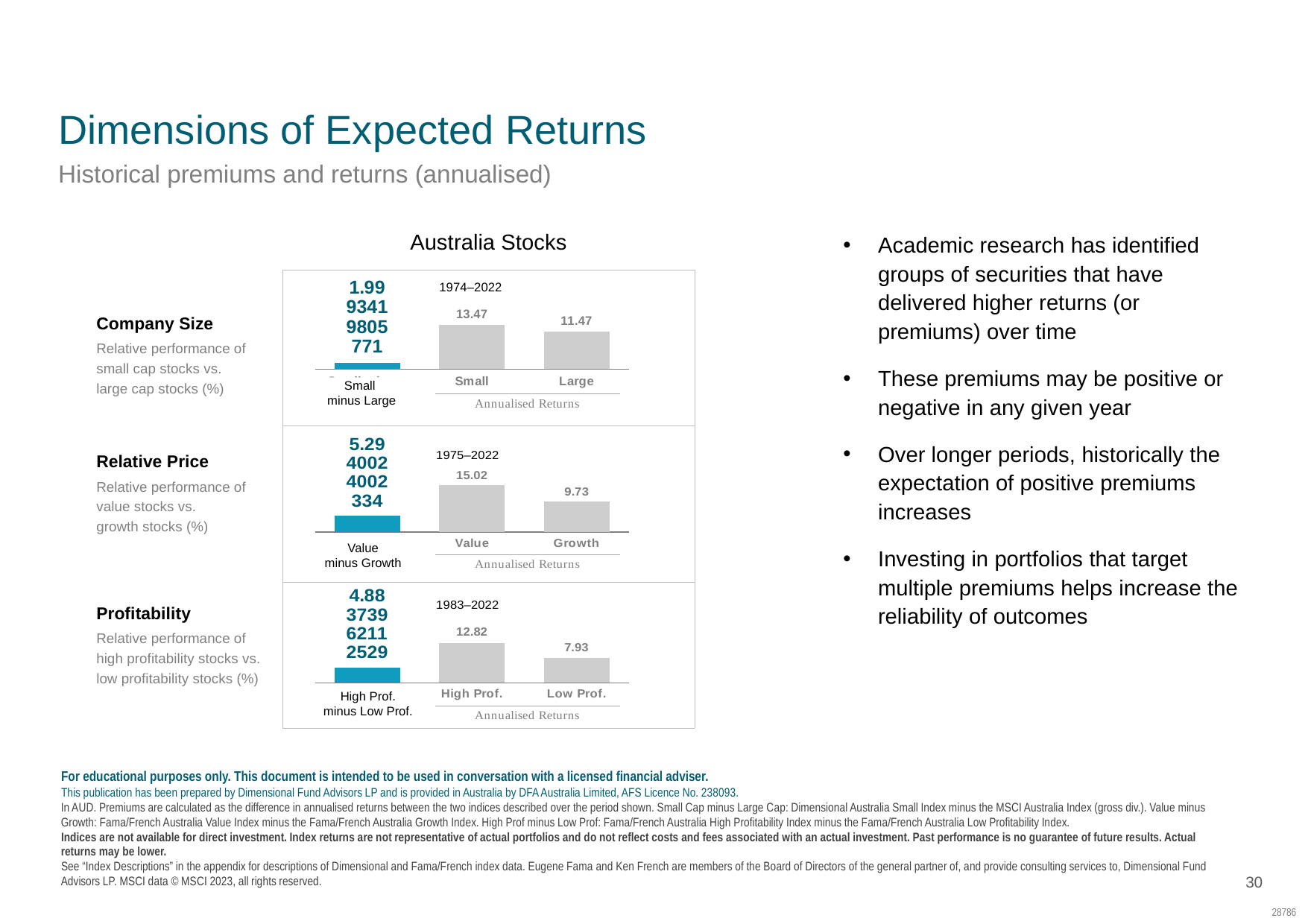
In the Relative Price panel, what is the annualised return for Growth? 9.73 In the Relative Price panel, what is the annualised return for Value? 15.02 In the Company Size panel, what is the annualised return for Large? 11.47 In the Profitability panel, what is the annualised return for Low Prof.? 7.93 In the Company Size panel, what is the annualised return for Small? 13.47 In the Profitability panel, which has the higher annualised return, High Prof. or Low Prof.? High Prof. How many bars are in the Annualised Returns chart of the Profitability panel? 2 In the Relative Price panel, what is the difference between the Value and Growth annualised returns? 5.29 What kind of chart is used to show the annualised returns in each panel? Bar chart In the Company Size panel, which category has the lower annualised return? Large What is the title above the three chart panels? Australia Stocks What period is shown for the Profitability panel? 1983–2022